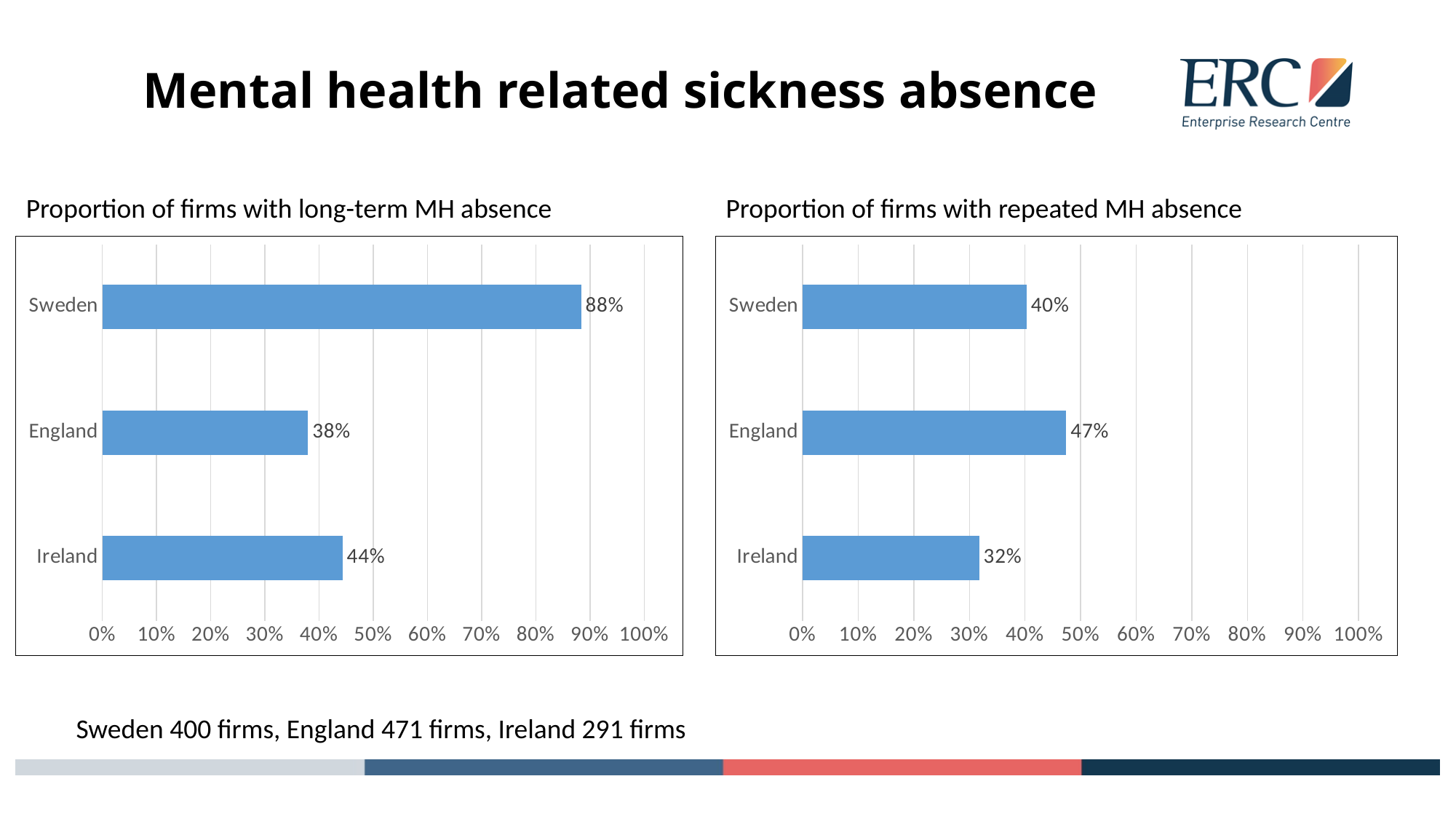
What kind of chart is the 'Proportion of firms with long-term MH absence' chart? Bar chart In the 'Proportion of firms with long-term MH absence' chart, which country has the lowest value? England How many countries are shown in the 'Proportion of firms with repeated MH absence' chart? 3 In the 'Proportion of firms with long-term MH absence' chart, is the value for Ireland greater or less than 50%? less In the 'Proportion of firms with repeated MH absence' chart, which country has the lowest value? Ireland In the 'Proportion of firms with repeated MH absence' chart, what is the value for England? 47% In the 'Proportion of firms with repeated MH absence' chart, what is the difference between England and Ireland? 15% In the 'Proportion of firms with repeated MH absence' chart, which is larger, Sweden or England? England In the 'Proportion of firms with long-term MH absence' chart, what is the value for Sweden? 88% In the 'Proportion of firms with long-term MH absence' chart, which country has the highest value? Sweden In the 'Proportion of firms with repeated MH absence' chart, what is the value for Ireland? 32% In the 'Proportion of firms with long-term MH absence' chart, what is the difference between Sweden and England? 50%